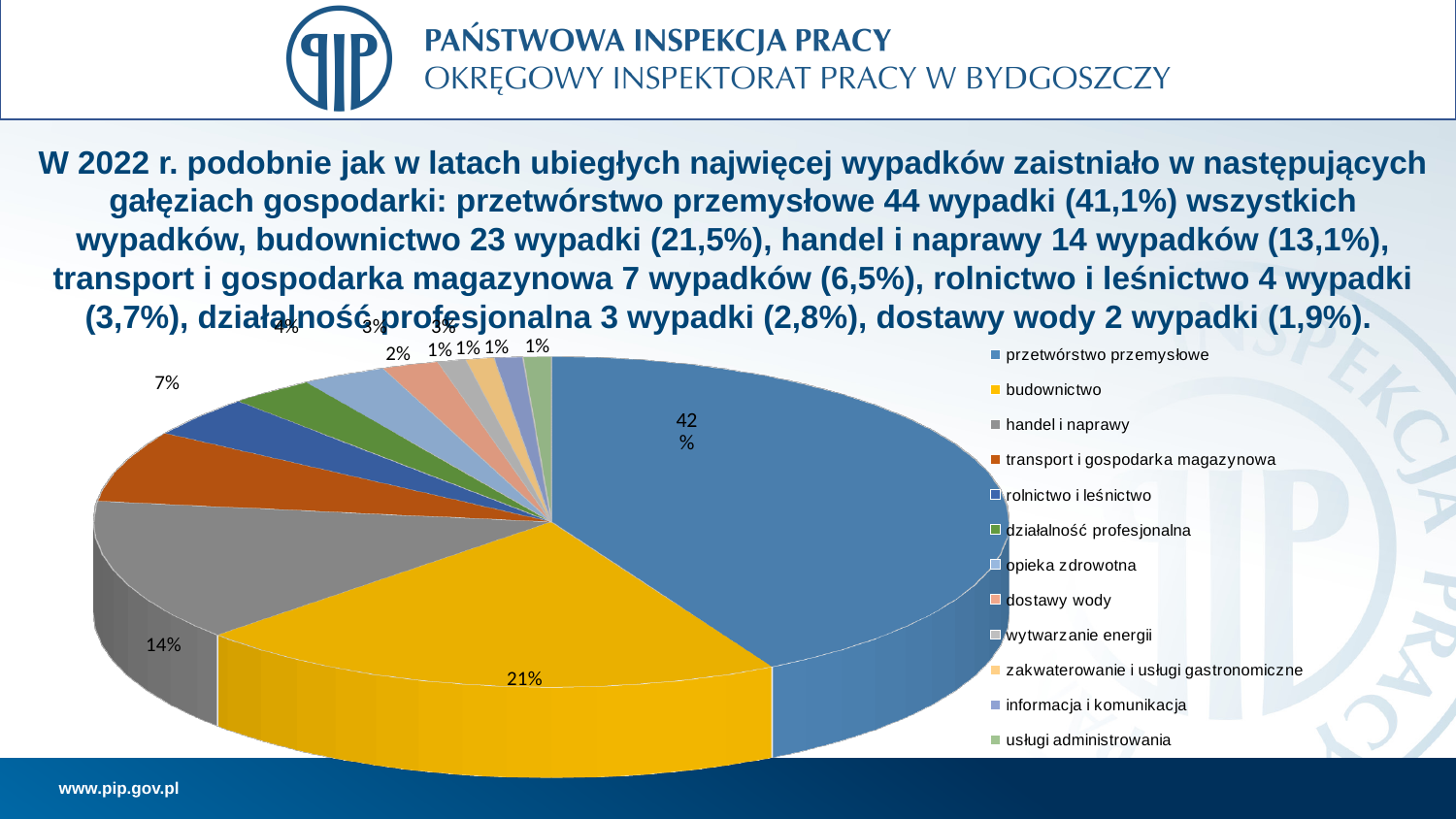
What share of the pie does transport i gospodarka magazynowa have? 7% What is the difference in percentage points between the shares of budownictwo and handel i naprawy? 7 percentage points What is the difference in percentage points between the shares of przetwórstwo przemysłowe and budownictwo? 21 percentage points How many categories does the legend of the pie chart list? 12 What share of the pie does przetwórstwo przemysłowe have? 42% What share of the pie does dostawy wody have? 2% What kind of chart is shown on the slide? pie chart Which category has the largest slice of the pie? przetwórstwo przemysłowe What share of the pie does budownictwo have? 21% Which has a larger share of the pie, budownictwo or handel i naprawy? budownictwo What share of the pie does handel i naprawy have? 14% What colour is the slice for przetwórstwo przemysłowe? blue